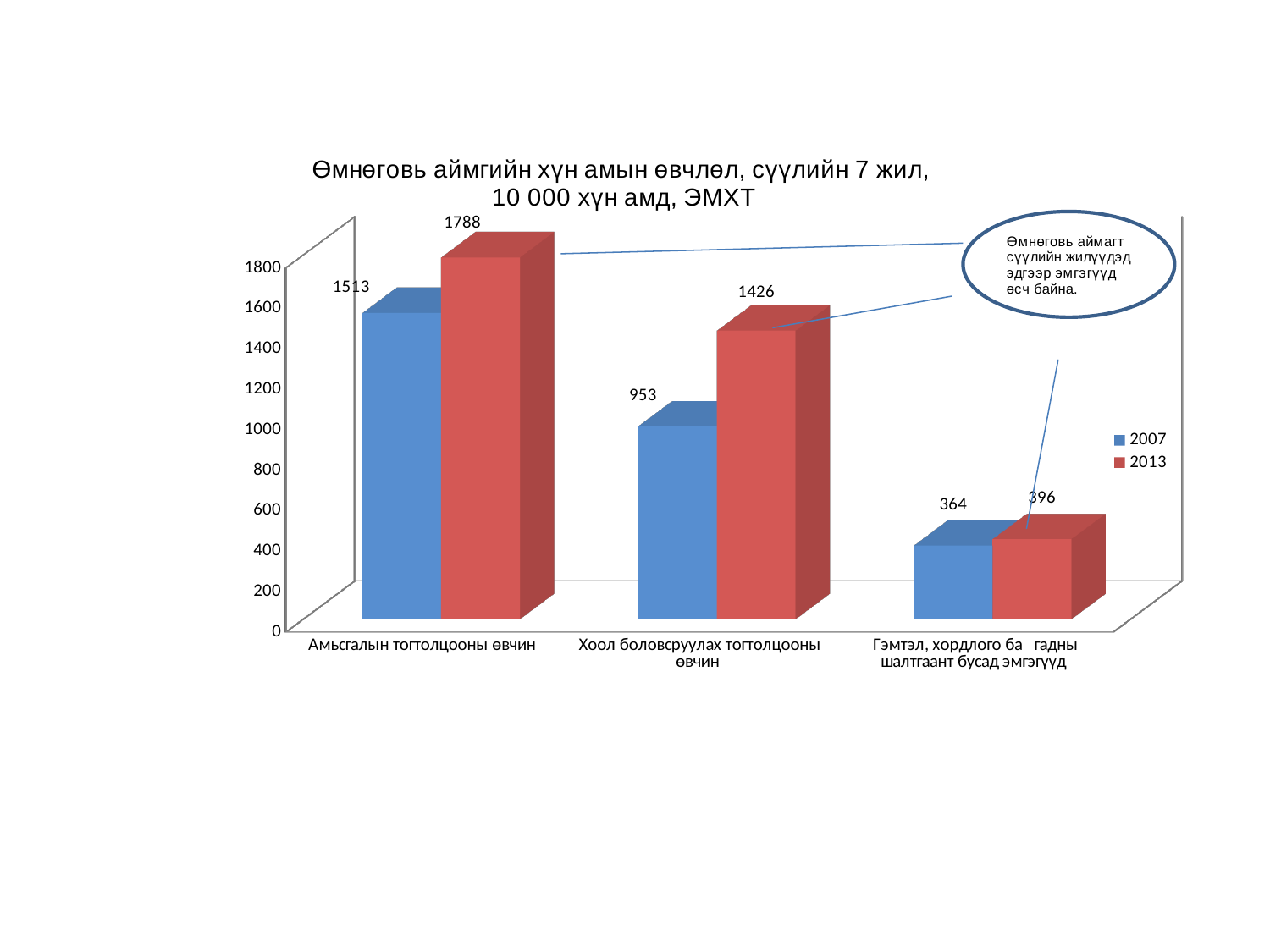
How many series does the legend list? 2 What is the difference between the 2013 and 2007 values for Хоол боловсруулах тогтолцооны өвчин? 473 What is the 2013 value for Хоол боловсруулах тогтолцооны өвчин? 1426 What is the difference between the 2013 and 2007 values for Амьсгалын тогтолцооны өвчин? 275 Which colour represents the 2013 series in the legend? Red How many categories are shown on the x axis? 3 For Хоол боловсруулах тогтолцооны өвчин, which year has the larger value, 2007 or 2013? 2013 What kind of chart is shown on the slide? Bar chart What is the 2013 value for Гэмтэл, хордлого ба гадны шалтгаант бусад эмгэгүүд? 396 Which category has the lowest 2007 value? Гэмтэл, хордлого ба гадны шалтгаант бусад эмгэгүүд Which category has the highest 2013 value? Амьсгалын тогтолцооны өвчин What is the 2007 value for Амьсгалын тогтолцооны өвчин? 1513